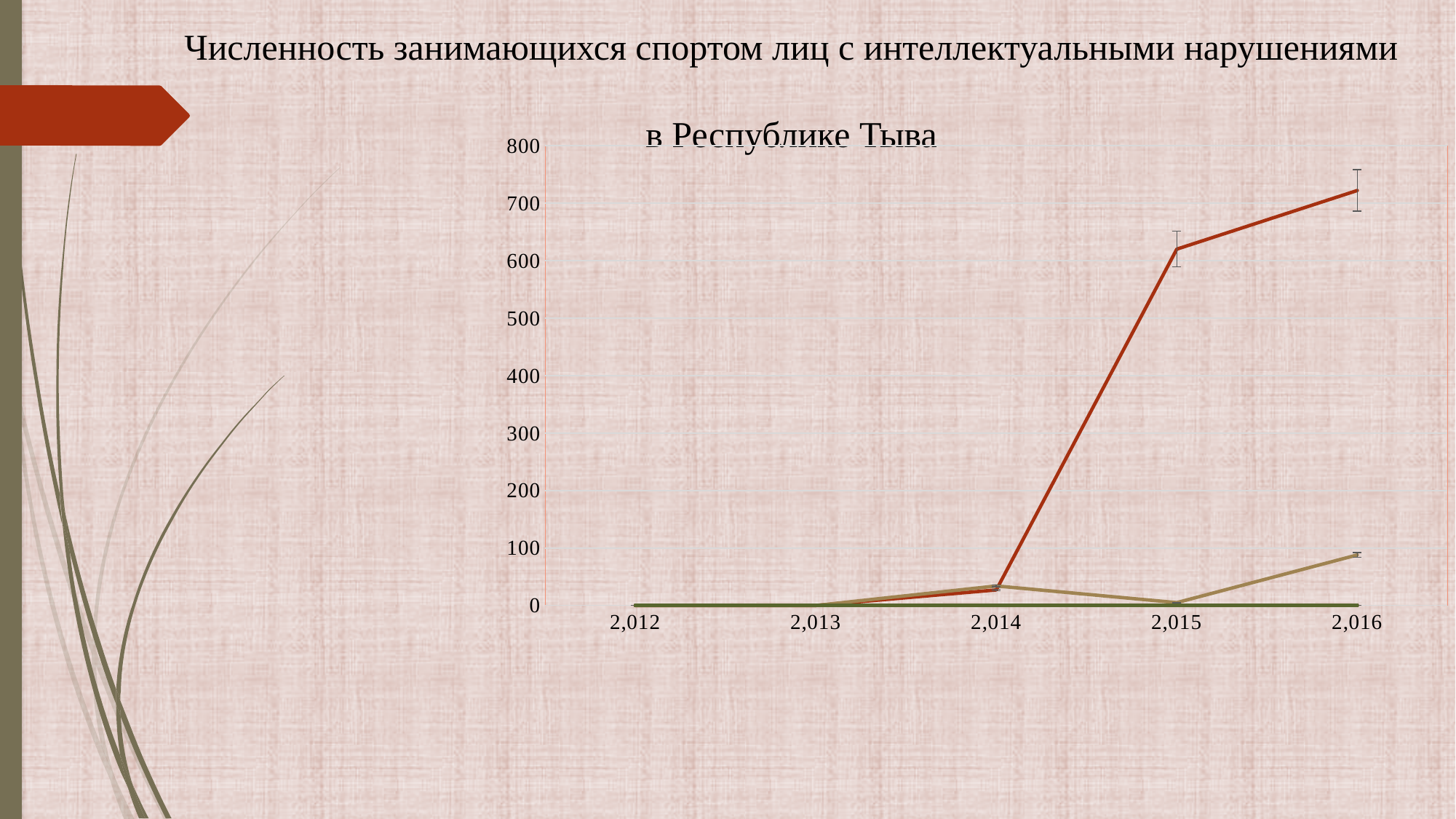
What kind of chart is shown on the slide? line chart Is the value of the red line in 2,015 greater or less than 500? greater How many years are shown along the x axis of the chart? 5 In which year does the red line reach its highest value? 2,016 What is the first year shown on the x axis of the chart? 2,012 Is the value of the red line in 2,014 greater or less than 100? less Is the value of the red line in 2,016 greater or less than 700? greater What is the last year shown on the x axis of the chart? 2,016 In 2,016, which line has the larger value, the red line or the tan line? the red line Does the red line rise or fall between 2,014 and 2,016? rise